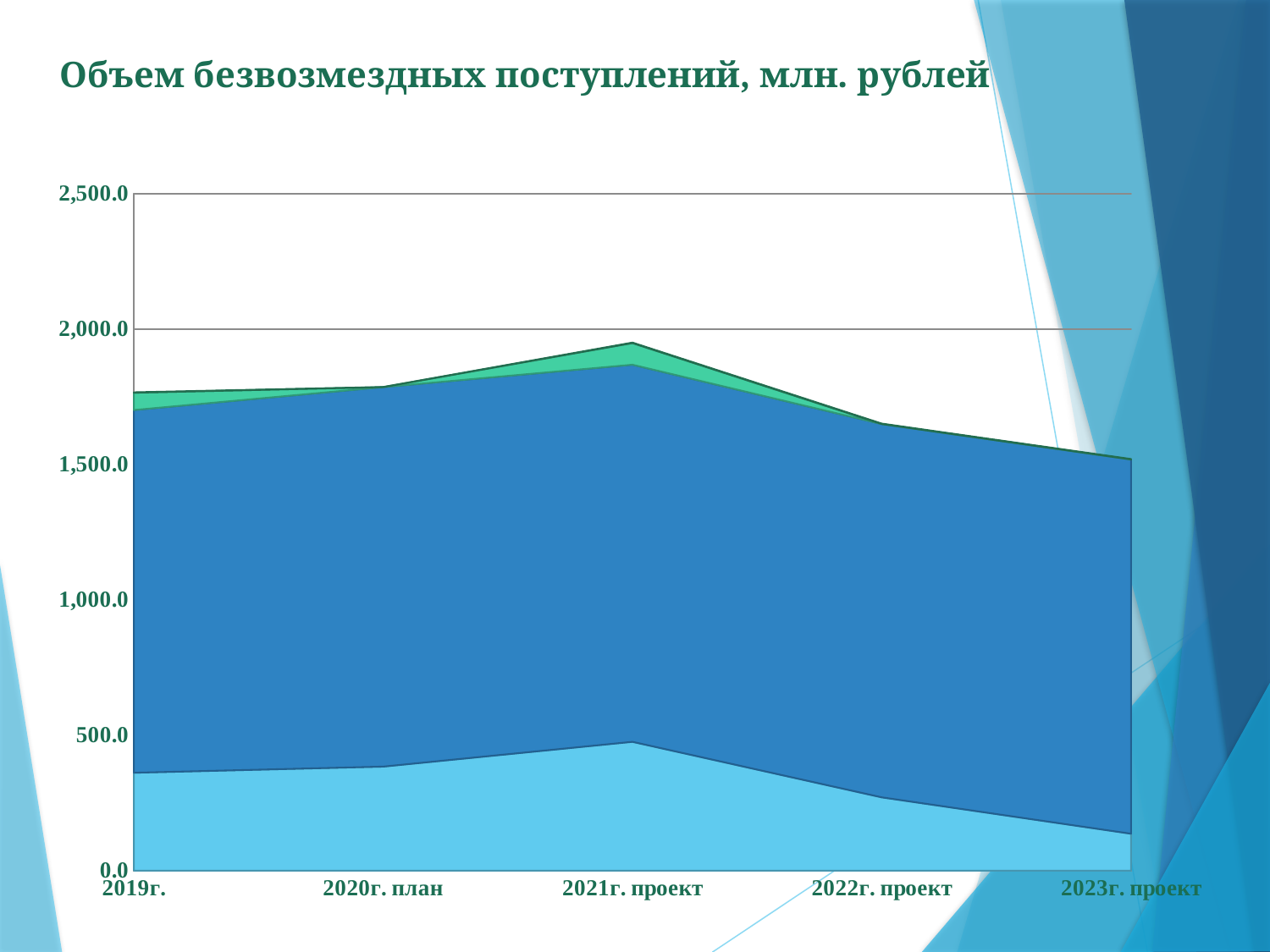
Is the value of the bottom (light blue) series for 2023г. проект greater or less than 500.0? less Which has the larger total: 2021г. проект or 2022г. проект? 2021г. проект What kind of chart is shown on the slide? Area chart Is the total for 2019г. greater or less than 1,500.0? greater Is the total for 2021г. проект greater or less than 2,000.0? less Which category has the lowest total (top of the stacked area)? 2023г. проект What is the title of the chart? Объем безвозмездных поступлений, млн. рублей How many categories are shown on the x axis? 5 Which category has the highest total (top of the stacked area)? 2021г. проект Which has the larger total: 2019г. or 2023г. проект? 2019г. Does the total rise or fall from 2021г. проект to 2023г. проект? fall